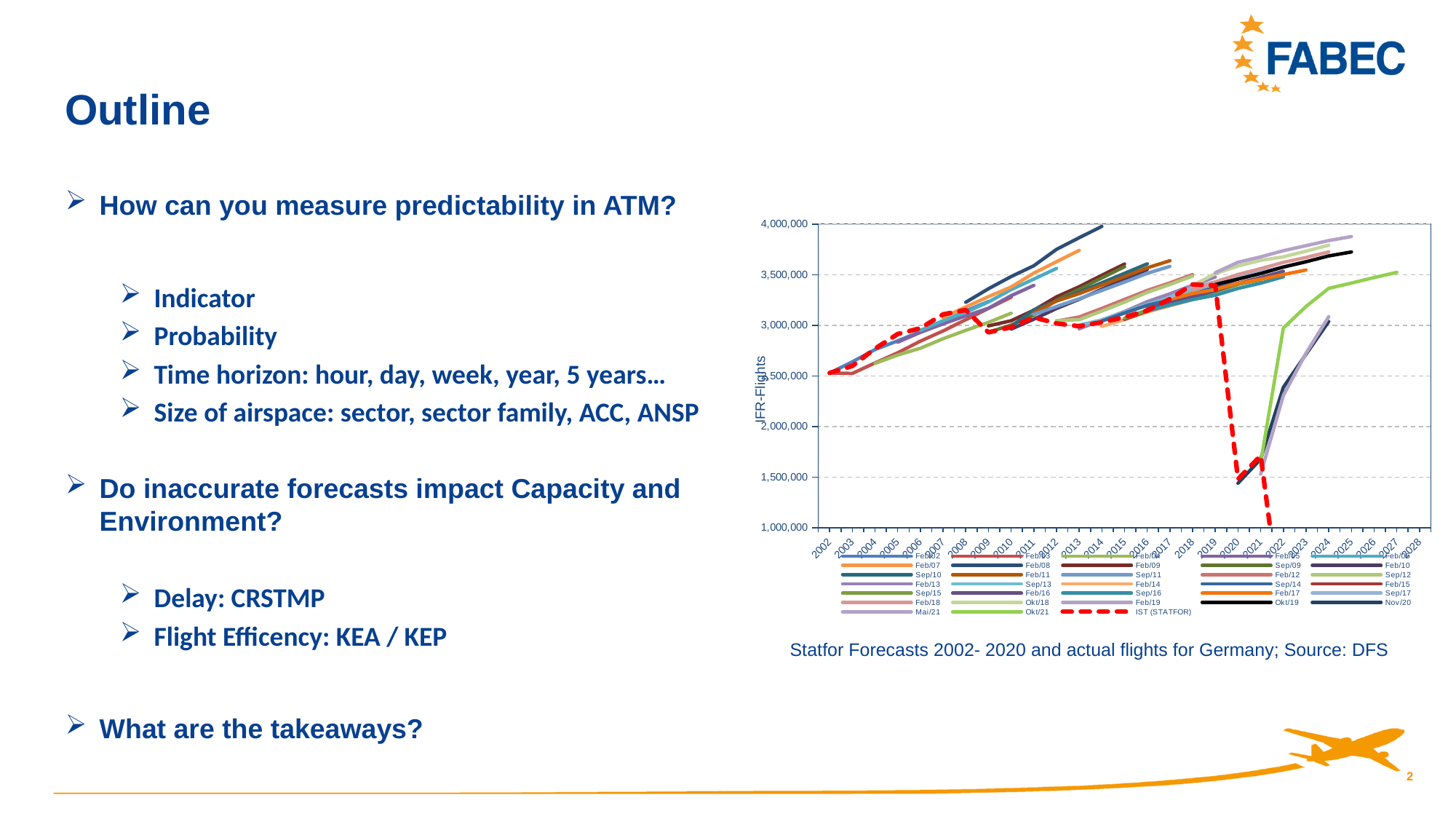
Does the IST (STATFOR) line rise or fall between 2019 and 2020? fall Is the IST (STATFOR) value for 2019 greater or less than 3,000,000? greater Which legend entry is drawn as a red dashed line? IST (STATFOR) What is the highest value shown on the vertical axis? 4,000,000 What is the label on the vertical axis of the chart? IFR-Flights What is the first year shown on the horizontal axis? 2002 What is the lowest value shown on the vertical axis? 1,000,000 What kind of chart is shown on the slide? line chart Does the IST (STATFOR) line rise or fall between 2002 and 2008? rise What is the last year shown on the horizontal axis? 2028 According to the caption, what is the source of the chart data? DFS Is the IST (STATFOR) value for 2002 greater or less than 3,000,000? less